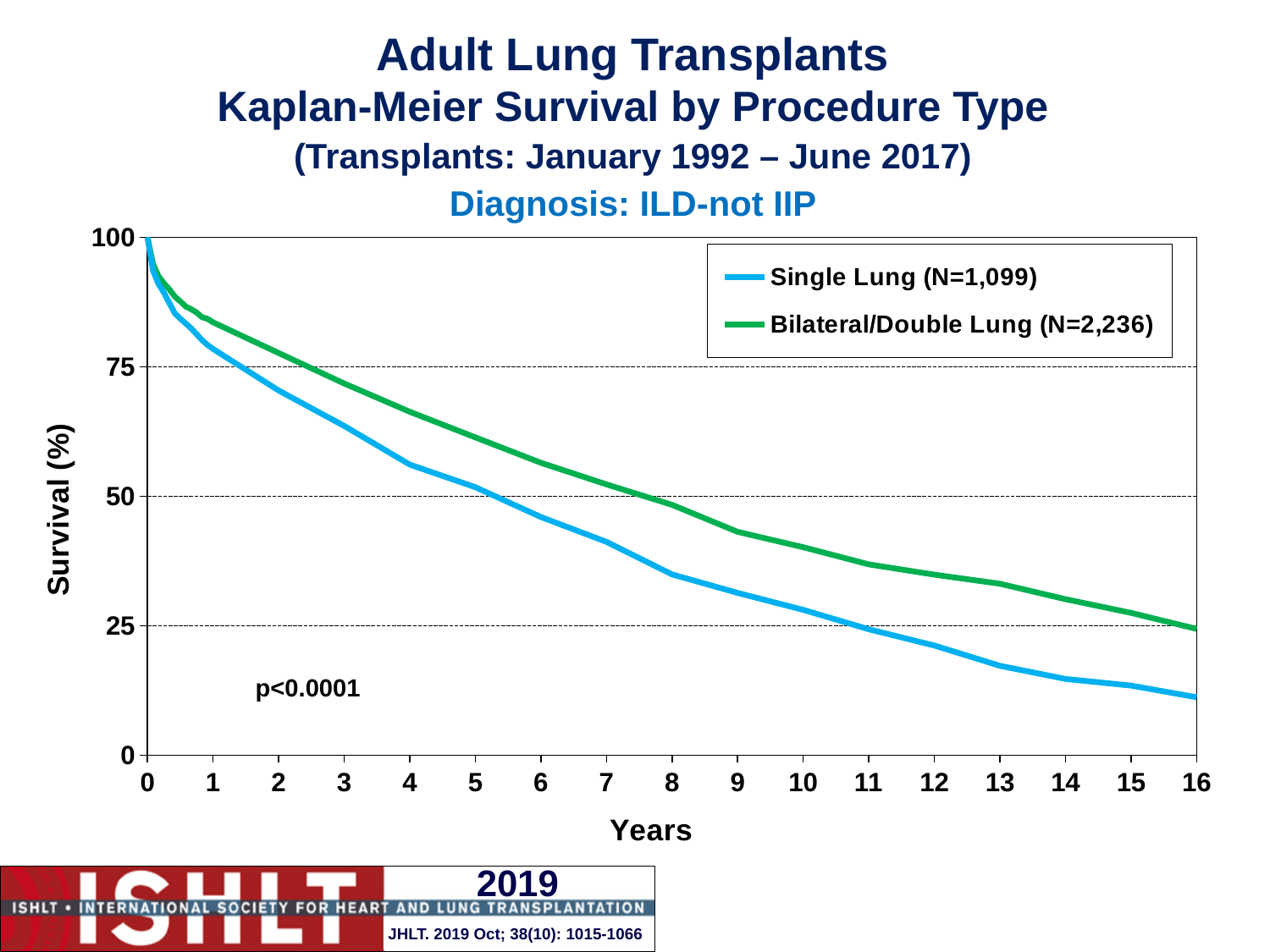
What is the number of patients (N) in the Bilateral/Double Lung group according to the legend? 2,236 Is the survival for Single Lung at 8 years greater or less than 50? less Is the survival for Bilateral/Double Lung at 1 year greater or less than 75? greater Is the survival for Bilateral/Double Lung at 4 years greater or less than 50? greater What kind of chart is shown on the slide? Line chart How many series does the legend list? 2 What p-value is printed on the chart? p<0.0001 Do the survival curves rise or fall as years increase? Fall At 10 years, which series has the higher survival, Single Lung or Bilateral/Double Lung? Bilateral/Double Lung